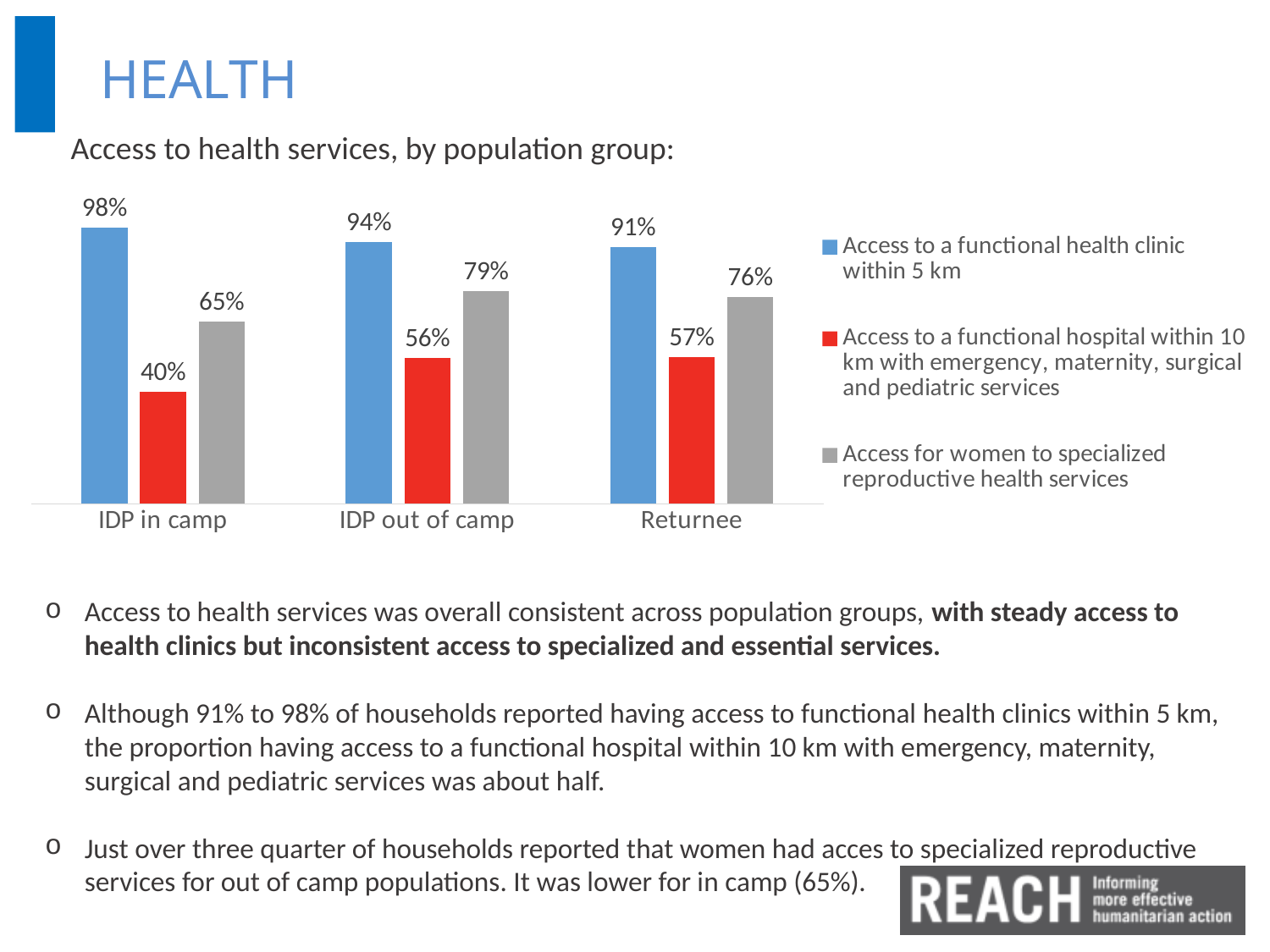
Which population group has the highest value for access to a functional health clinic within 5 km? IDP in camp How many population groups are shown on the x axis of the chart? 3 Which population group has the lowest value for access to a functional hospital within 10 km? IDP in camp Does the value for access to a functional health clinic within 5 km rise or fall from IDP in camp to Returnee? Fall Which is larger: access for women to specialized reproductive health services for IDP out of camp or for Returnee? IDP out of camp How many series does the chart legend list? 3 What type of chart is shown on the slide? Bar chart What is the value for IDP out of camp for access for women to specialized reproductive health services? 79% Which colour represents access for women to specialized reproductive health services in the chart? Grey What percentage of IDP in camp households reported access to a functional health clinic within 5 km? 98% What is the value for Returnee households for access to a functional hospital within 10 km with emergency, maternity, surgical and pediatric services? 57% What is the difference between access to a functional health clinic within 5 km and access to a functional hospital within 10 km for IDP in camp? 58%